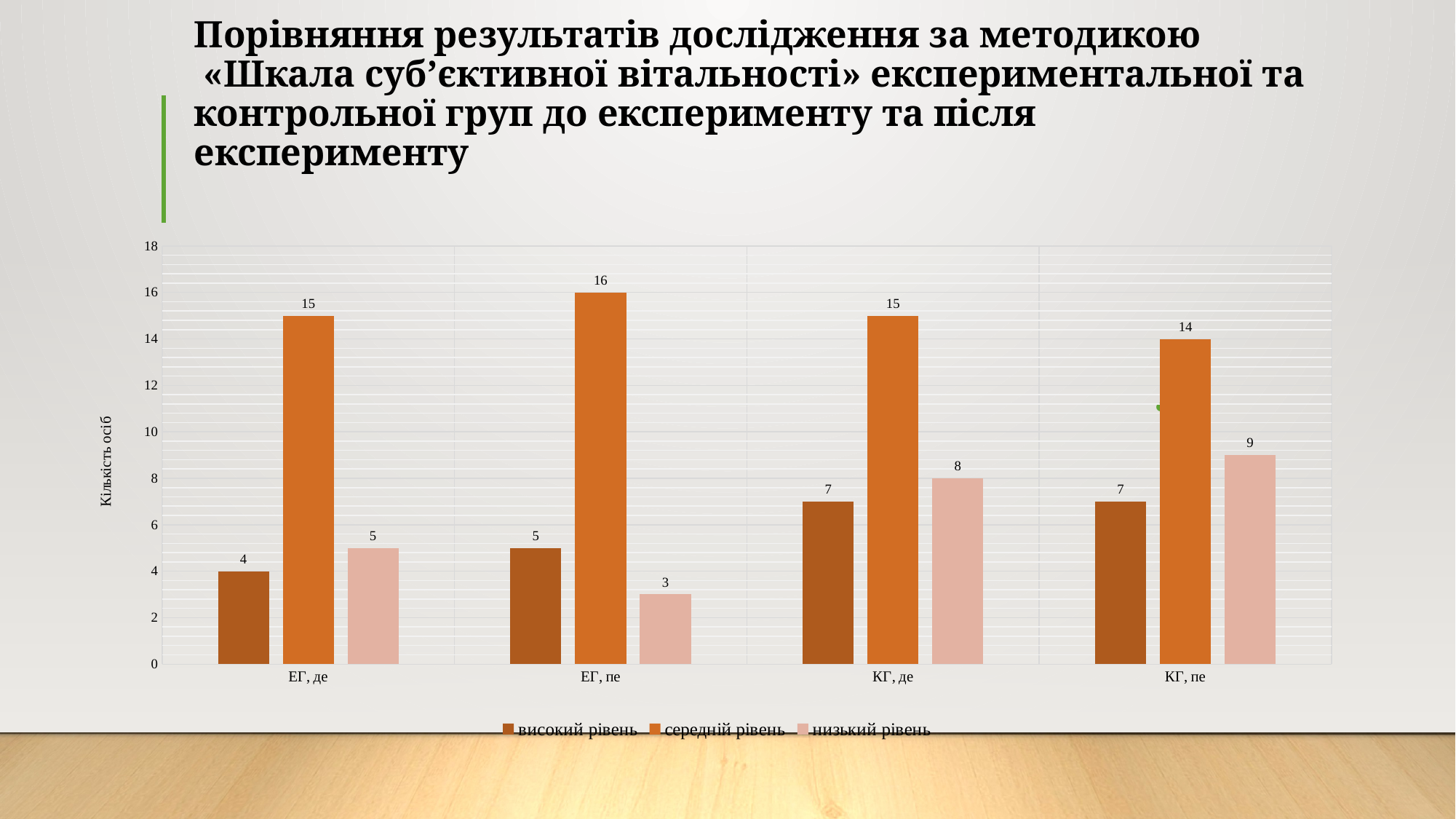
Which category has the lowest value for низький рівень? ЕГ, пе What is the value of низький рівень for КГ, пе? 9 How many categories are shown on the x axis? 4 How many series does the legend list? 3 Which category has the highest value for середній рівень? ЕГ, пе What is the value of високий рівень for ЕГ, де? 4 What is the value of низький рівень for ЕГ, пе? 3 Which is larger: низький рівень for КГ, де or низький рівень for ЕГ, де? КГ, де What is the value of середній рівень for ЕГ, пе? 16 What is the difference between середній рівень for ЕГ, пе and середній рівень for КГ, пе? 2 What kind of chart is shown on the slide? bar chart What is the label of the vertical axis? Кількість осіб